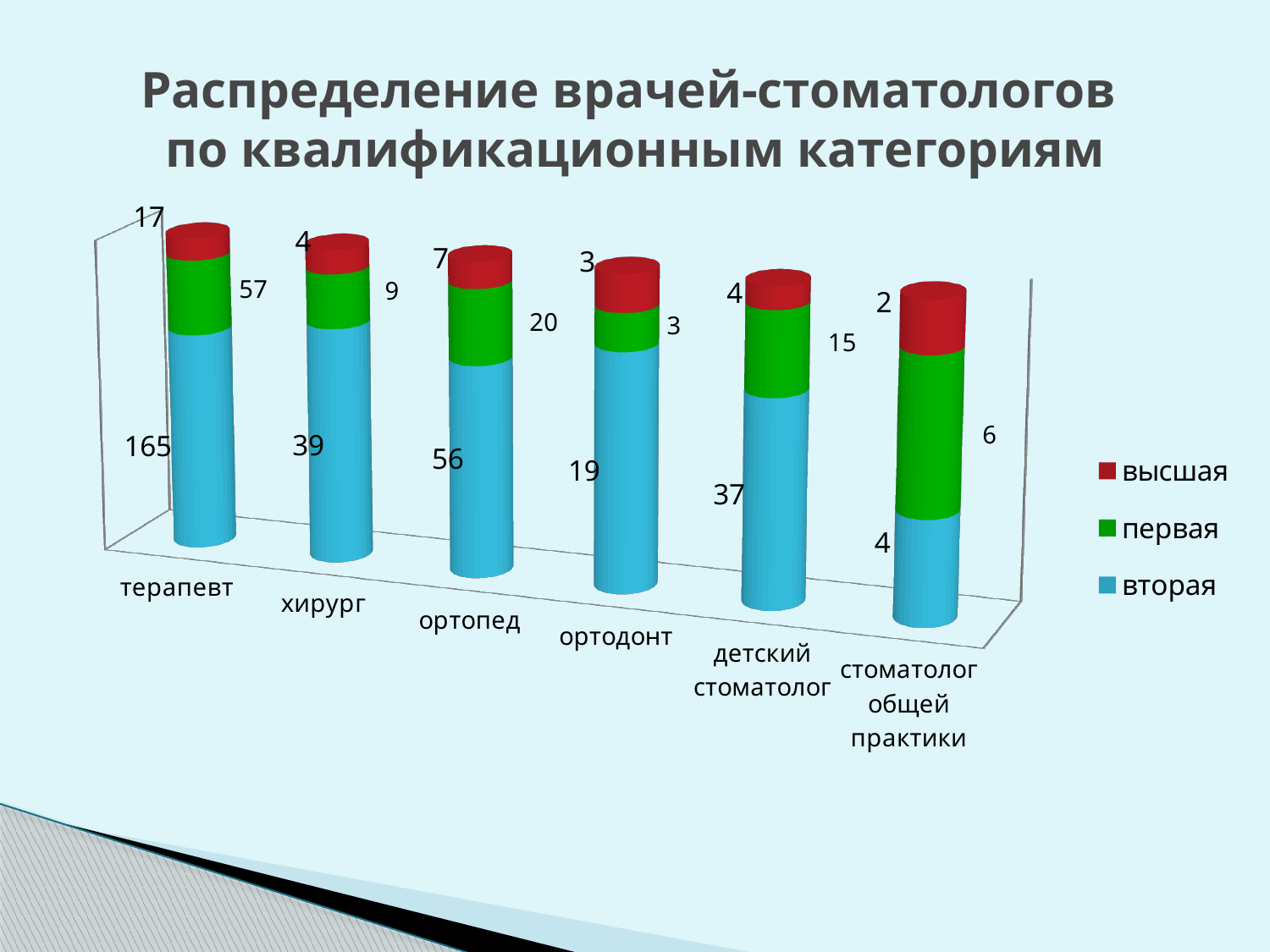
What is the value of the 'первая' series for 'стоматолог общей практики'? 6 What is the value of the 'высшая' series for 'хирург'? 4 What is the total of the three series for 'ортодонт'? 25 What is the value of the 'вторая' series for 'терапевт'? 165 Which category has the lowest value in the 'высшая' series? стоматолог общей практики What is the difference between the 'вторая' values for 'ортопед' and 'хирург'? 17 How many categories are shown on the x axis? 6 Which is larger: the 'первая' value for 'детский стоматолог' or for 'хирург'? детский стоматолог What kind of chart is shown on the slide? Stacked bar chart Which category has the highest value in the 'вторая' series? терапевт How many series does the legend list? 3 What is the value of the 'первая' series for 'ортопед'? 20